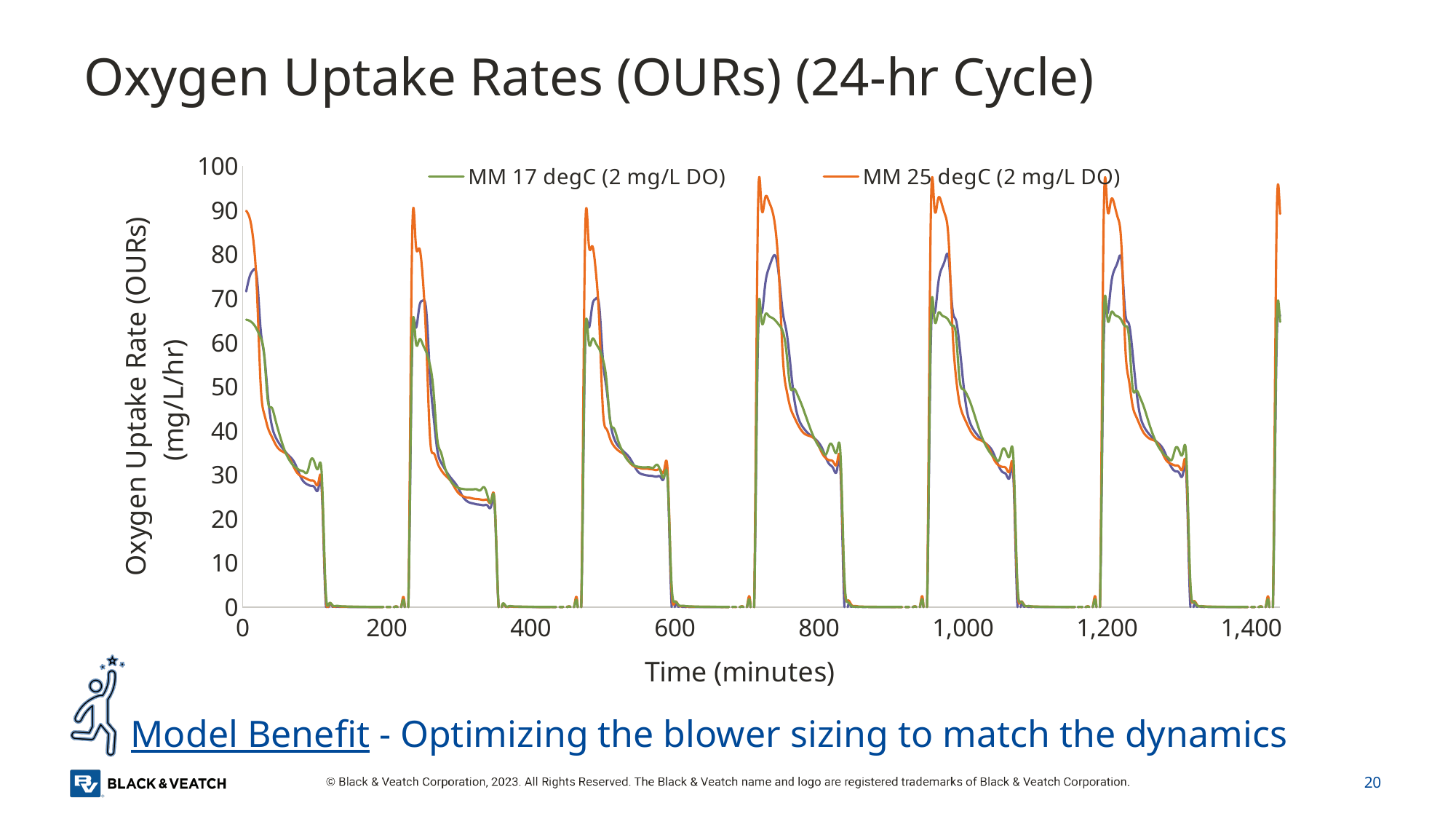
What kind of chart is shown on the slide? line chart What is the label of the x axis? Time (minutes) What is the title of the chart on the slide? Oxygen Uptake Rates (OURs) (24-hr Cycle) Between 0 and 100 minutes, do the plotted values rise or fall? fall How many times does the MM 25 degC (2 mg/L DO) line spike above 80 mg/L/hr across the chart? 7 Is the peak value of the MM 25 degC (2 mg/L DO) series near 720 minutes greater or less than 90? greater Which series reaches the higher peak oxygen uptake rate, MM 17 degC (2 mg/L DO) or MM 25 degC (2 mg/L DO)? MM 25 degC (2 mg/L DO) How many series does the chart legend list? 2 What is the largest tick value shown on the x axis? 1,400 Is the value of the MM 17 degC (2 mg/L DO) series at time 0 greater or less than 60? greater Is the highest value reached by the MM 17 degC (2 mg/L DO) series greater or less than 80? less